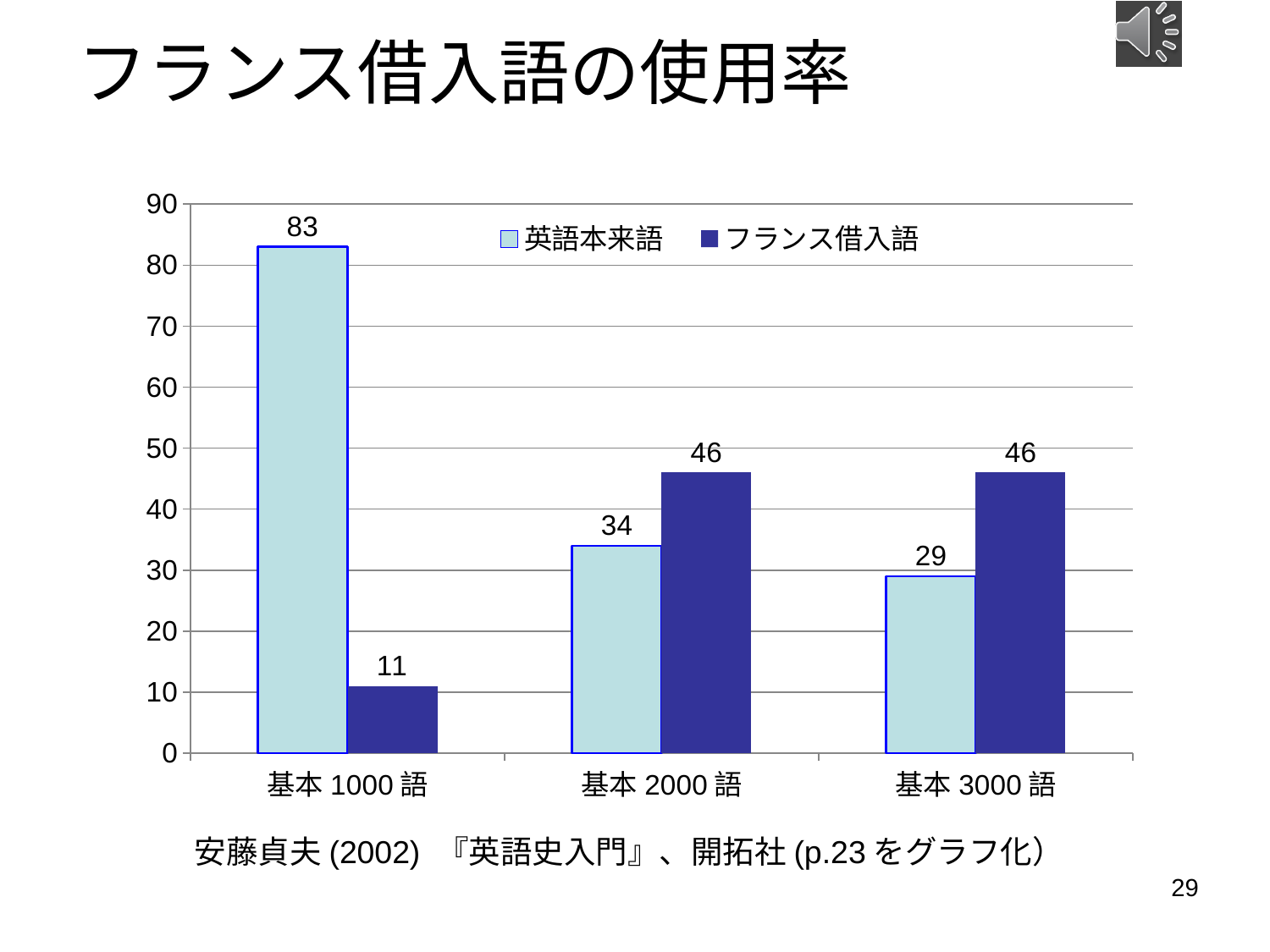
What is the value for フランス借入語 in the 基本 1000 語 category? 11 Which category has the lowest value for フランス借入語? 基本 1000 語 How many categories are shown on the x axis? 3 Do the values for 英語本来語 rise or fall from 基本 1000 語 to 基本 3000 語? fall What is the difference between 英語本来語 and フランス借入語 in the 基本 1000 語 category? 72 What is the value for 英語本来語 in the 基本 1000 語 category? 83 Which category has the highest value for 英語本来語? 基本 1000 語 What is the value for フランス借入語 in the 基本 3000 語 category? 46 How many series does the legend list? 2 What is the value for 英語本来語 in the 基本 2000 語 category? 34 In the 基本 2000 語 category, which series has the larger value, 英語本来語 or フランス借入語? フランス借入語 What kind of chart is shown on the slide? bar chart